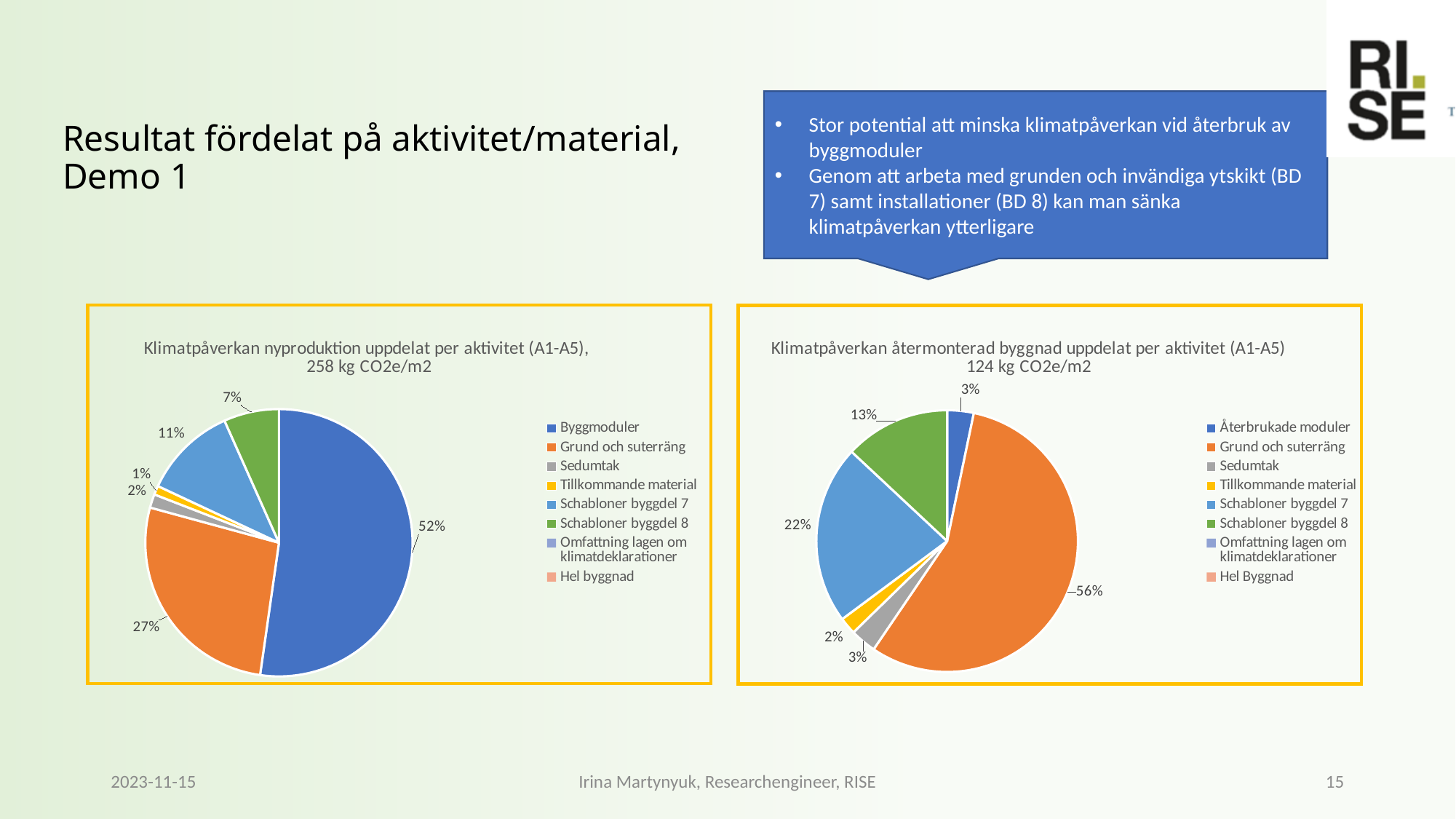
In the left pie chart (Klimatpåverkan nyproduktion), what share does Schabloner byggdel 7 have? 11% In the right pie chart (Klimatpåverkan återmonterad byggnad), what share does Schabloner byggdel 8 have? 13% In the right pie chart (Klimatpåverkan återmonterad byggnad), which category has the largest slice? Grund och suterräng In the left pie chart (Klimatpåverkan nyproduktion), what share does Byggmoduler have? 52% In the right pie chart (Klimatpåverkan återmonterad byggnad), what is the difference between the shares of Grund och suterräng and Schabloner byggdel 7? 34 percentage points How many entries does the legend of the left pie chart list? 8 In the left pie chart (Klimatpåverkan nyproduktion), which category has the largest slice? Byggmoduler What total value in kg CO2e/m2 is stated in the title of the right pie chart? 124 kg CO2e/m2 What type of chart is used on the left side of the slide? Pie chart